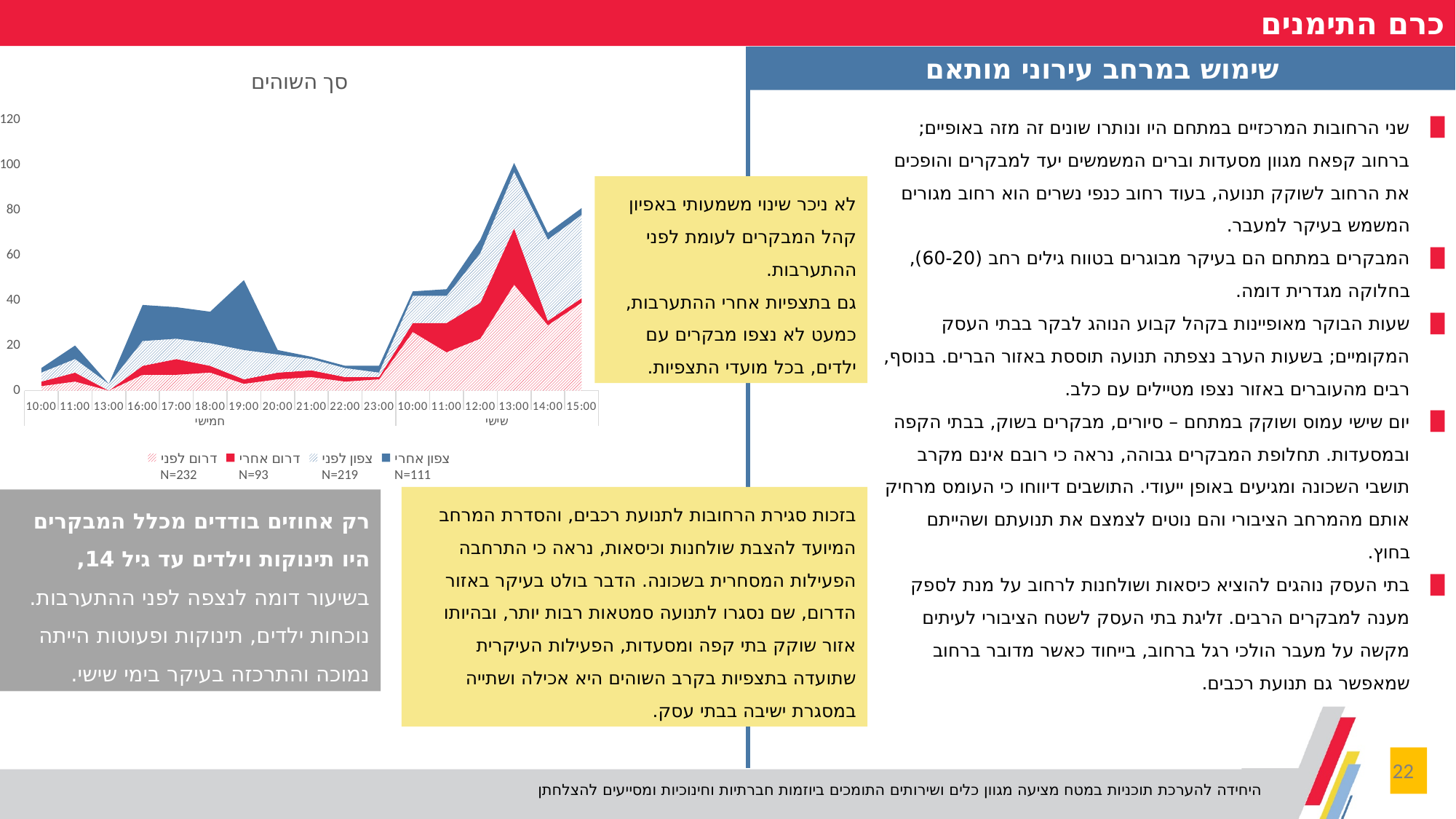
At which time point does the chart reach its highest value? שישי 13:00 Which two days are labelled on the x axis of the chart? חמישי and שישי Which is larger: the value for צפון לפני at 13:00 on Friday (שישי) or at 13:00 on Thursday (חמישי)? Friday (שישי) 13:00 Do the values on Friday (שישי) rise or fall from 10:00 to 13:00? rise What is the title of the chart on the slide? סך השוהים What kind of chart is shown under the title "סך השוהים"? area chart How many time points are shown along the x axis of the chart? 17 At which time point on Thursday (חמישי) are the values lowest? 13:00 How many series does the chart legend list? 4